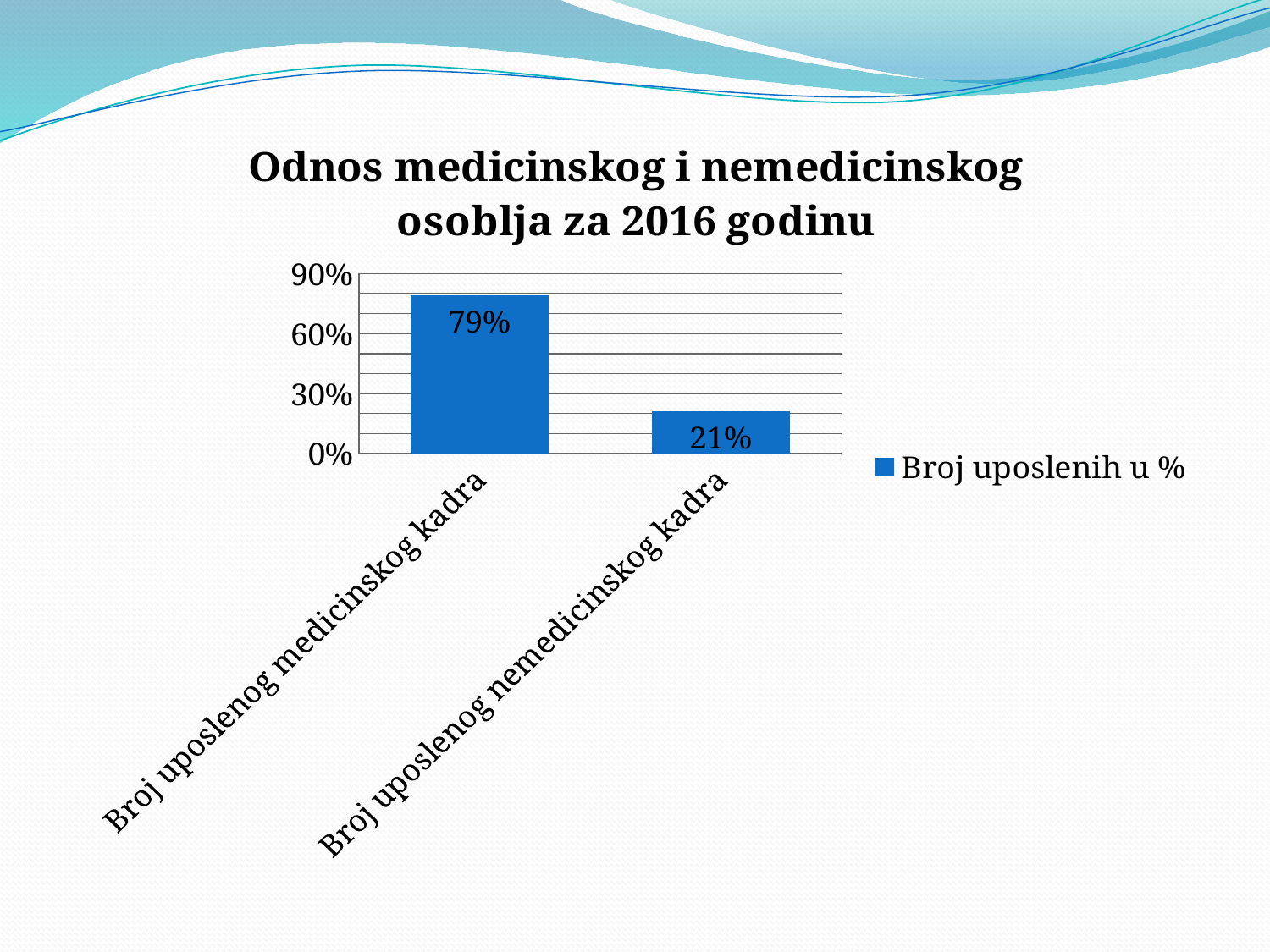
What is the difference between the values for Broj uposlenog medicinskog kadra and Broj uposlenog nemedicinskog kadra? 58% How many categories are shown on the x axis? 2 Is the value for Broj uposlenog nemedicinskog kadra greater or less than 30%? less What is the value for Broj uposlenog medicinskog kadra? 79% What is the value for Broj uposlenog nemedicinskog kadra? 21% Which is larger, the value for Broj uposlenog medicinskog kadra or Broj uposlenog nemedicinskog kadra? Broj uposlenog medicinskog kadra Is the value for Broj uposlenog medicinskog kadra greater or less than 60%? greater What kind of chart is shown on the slide? bar chart How many series does the legend list? 1 What is the title of the chart? Odnos medicinskog i nemedicinskog osoblja za 2016 godinu Which category has the highest value? Broj uposlenog medicinskog kadra Which category has the lowest value? Broj uposlenog nemedicinskog kadra